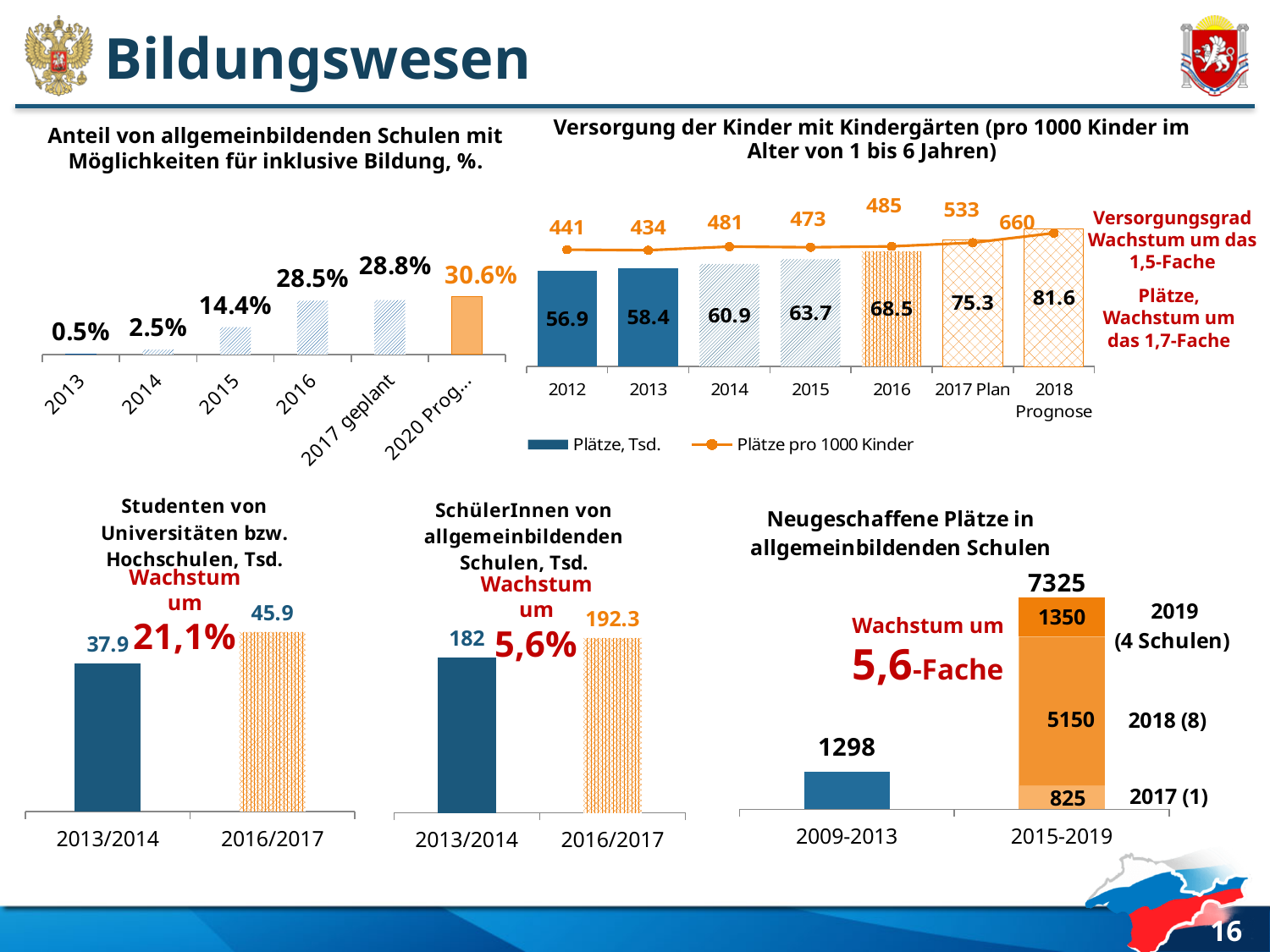
In the chart 'Versorgung der Kinder mit Kindergärten', how many years are shown on the x axis? 7 In the chart 'Neugeschaffene Plätze in allgemeinbildenden Schulen', what is the value of the 2018 (8) segment? 5150 In the chart 'Neugeschaffene Plätze in allgemeinbildenden Schulen', what is the total of the stacked bar for 2015-2019? 7325 In the chart 'Versorgung der Kinder mit Kindergärten', what is the value of 'Plätze, Tsd.' for 2015? 63.7 In the chart 'Versorgung der Kinder mit Kindergärten', what is the difference in 'Plätze pro 1000 Kinder' between 2017 Plan and 2016? 48 In the chart 'Versorgung der Kinder mit Kindergärten', how many series does the legend list? 2 In the chart 'Anteil von allgemeinbildenden Schulen mit Möglichkeiten für inklusive Bildung, %.', do the values rise or fall from 2013 to 2020 Prog...? rise In the chart 'Anteil von allgemeinbildenden Schulen mit Möglichkeiten für inklusive Bildung, %.', which year has the lowest value? 2013 In the chart 'Anteil von allgemeinbildenden Schulen mit Möglichkeiten für inklusive Bildung, %.', what is the value for 2015? 14.4% In the chart 'Studenten von Universitäten bzw. Hochschulen, Tsd.', what is the value for 2016/2017? 45.9 In the chart 'Versorgung der Kinder mit Kindergärten', what is the value of 'Plätze pro 1000 Kinder' for 2018 Prognose? 660 In the chart 'SchülerInnen von allgemeinbildenden Schulen, Tsd.', what is the difference between 2016/2017 and 2013/2014? 10.3